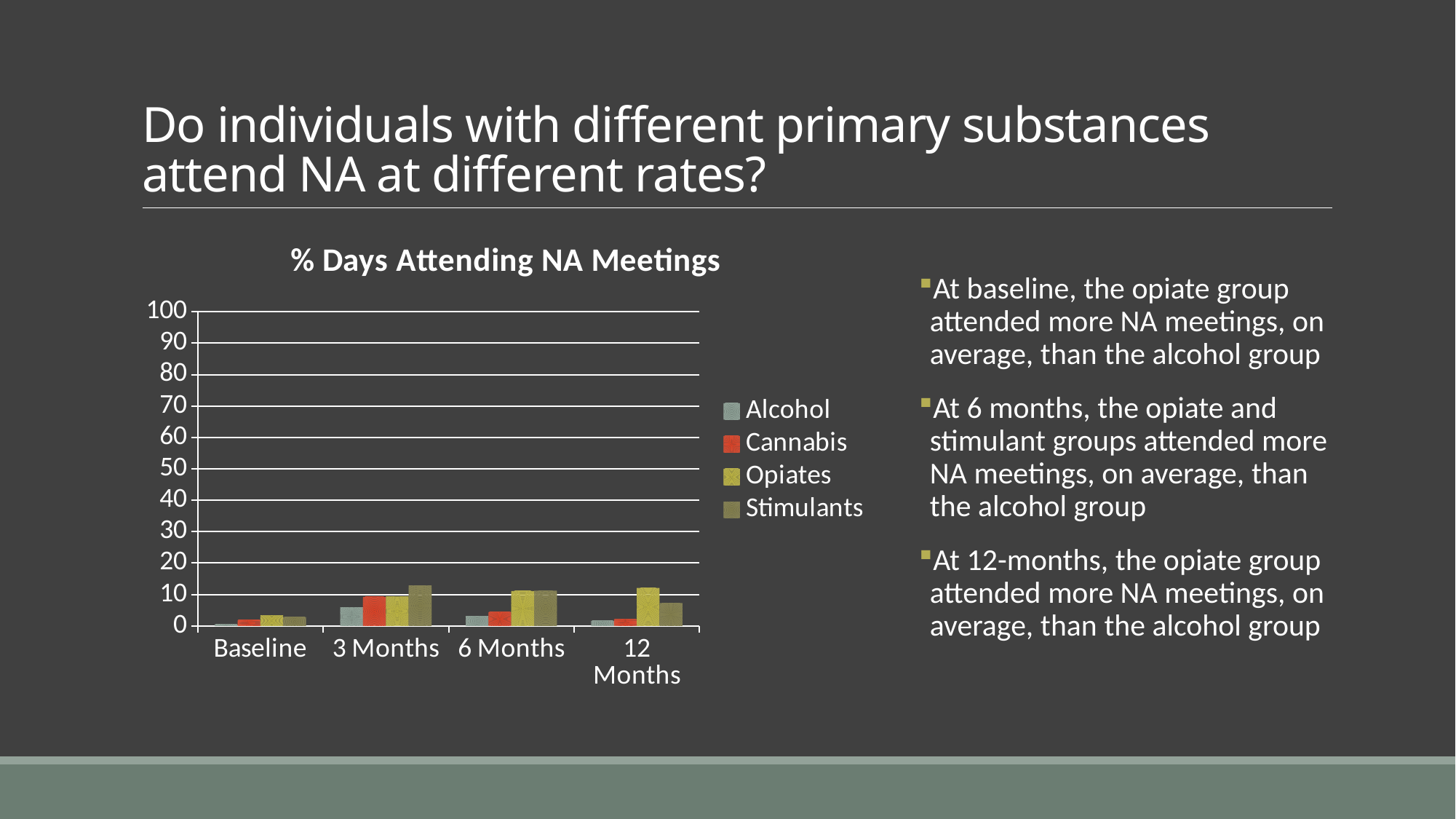
Is the value for Opiates at 12 Months greater or less than 10? greater What is the title of the chart? % Days Attending NA Meetings At 12 Months, which is larger: the value for Opiates or the value for Alcohol? Opiates Which group has the highest value at 3 Months? Stimulants Is the value for Alcohol at 3 Months greater or less than 10? less Is the value for Stimulants at 3 Months greater or less than 10? greater How many series does the chart's legend list? 4 What kind of chart is shown on the slide? Bar chart Which group has the lowest value at Baseline? Alcohol Which colour represents the Cannabis series in the chart? Red Which group has the highest value at 12 Months? Opiates How many time-point categories are shown on the x axis of the chart? 4